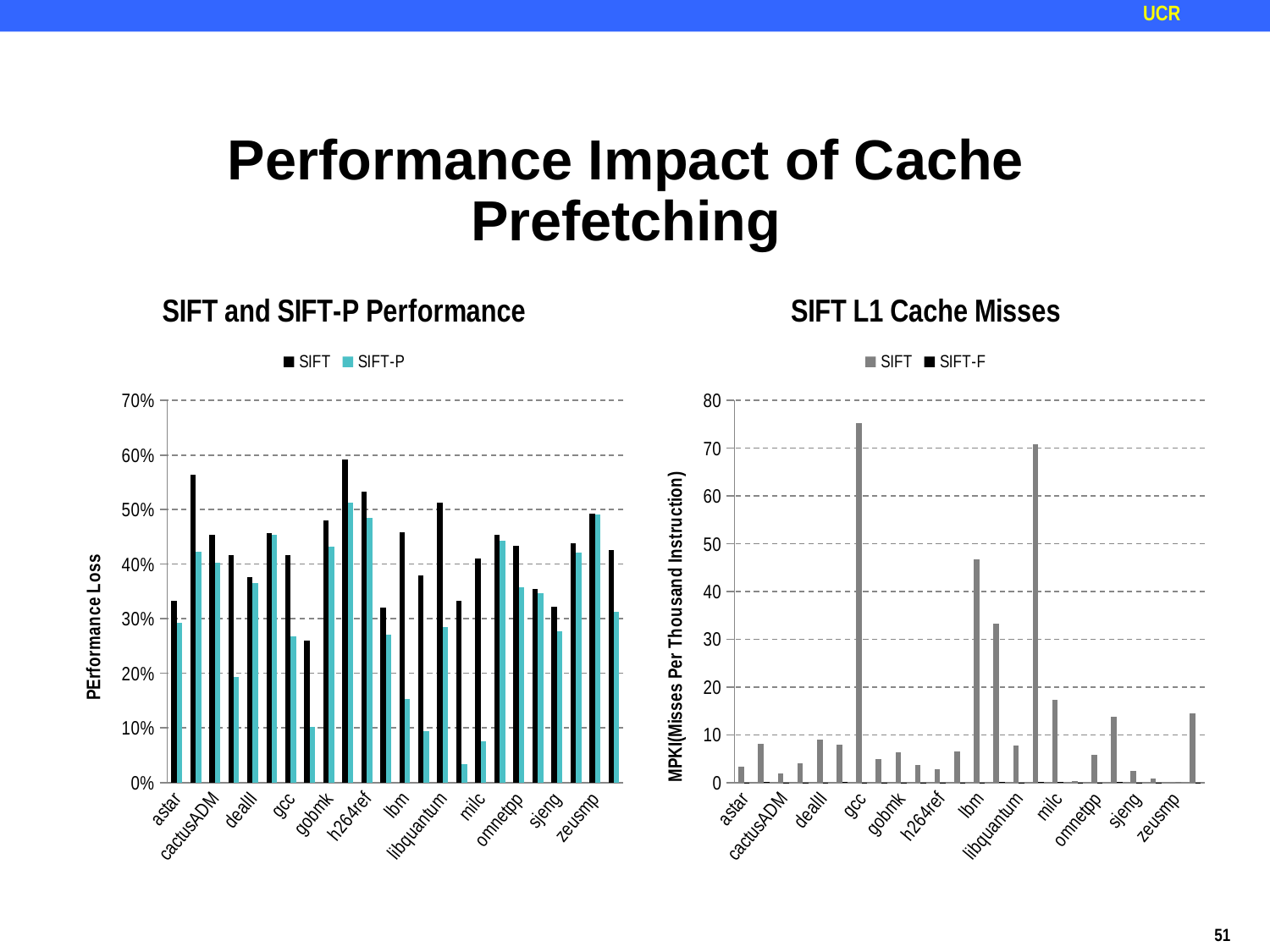
In the "SIFT L1 Cache Misses" chart, which labelled benchmark has the highest SIFT MPKI? gcc In the "SIFT L1 Cache Misses" chart, is the SIFT value for lbm greater or less than 40? greater In the "SIFT and SIFT-P Performance" chart, which is larger for astar, SIFT or SIFT-P? SIFT In the "SIFT L1 Cache Misses" chart, is the SIFT value for gcc greater or less than 70? greater What is the y-axis title of the "SIFT L1 Cache Misses" chart? MPKI(Misses Per Thousand Instruction) What kind of chart is the "SIFT L1 Cache Misses" chart? bar chart What kind of chart is the "SIFT and SIFT-P Performance" chart? bar chart How many series does the legend of the "SIFT and SIFT-P Performance" chart list? 2 In the "SIFT L1 Cache Misses" chart, is the SIFT value for astar greater or less than 10? less How many series does the legend of the "SIFT L1 Cache Misses" chart list? 2 What are the two legend entries of the "SIFT L1 Cache Misses" chart? SIFT and SIFT-F